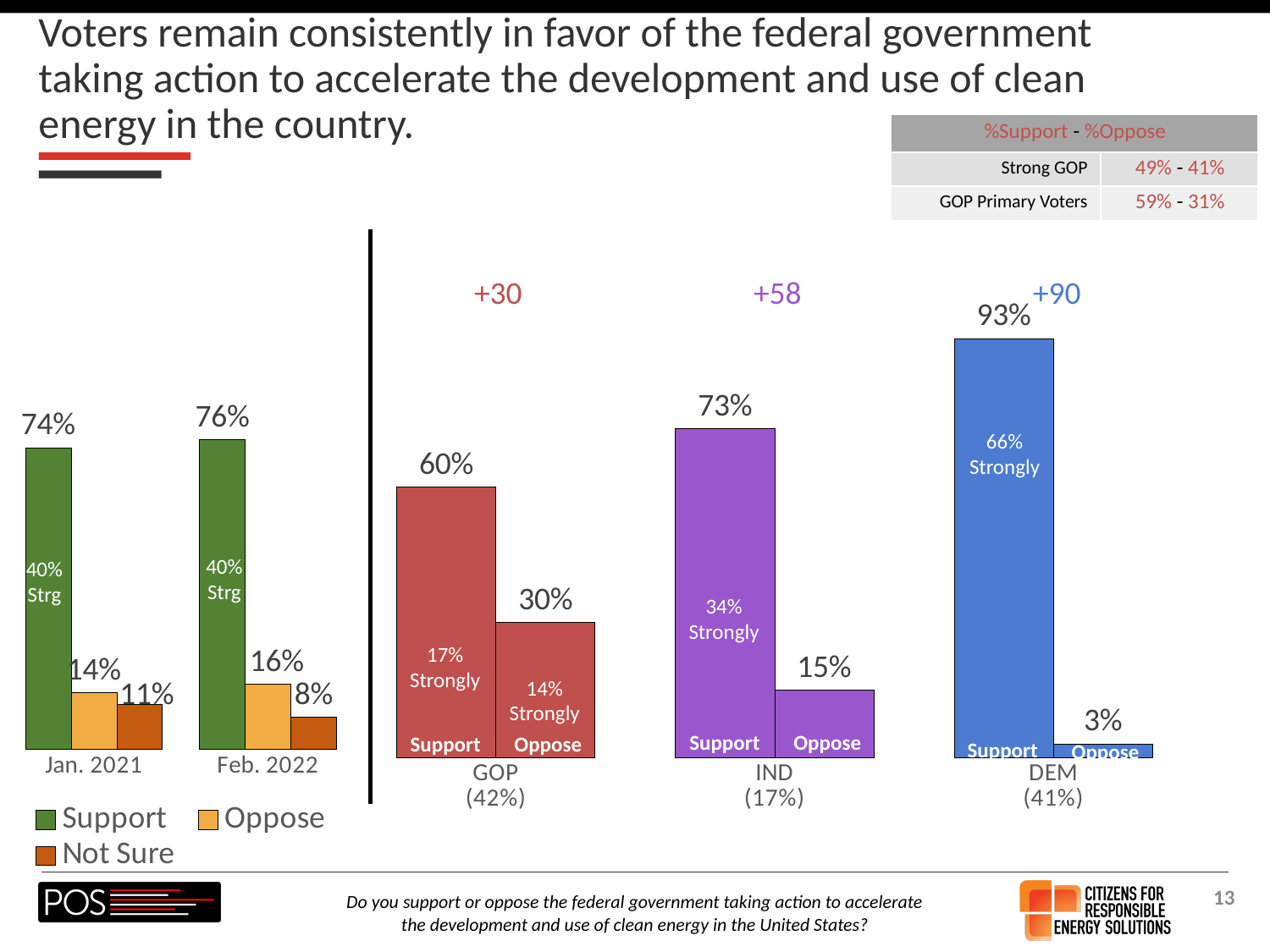
In the left chart, does Support rise or fall from Jan. 2021 to Feb. 2022? rise In the right chart (by party), what is the difference between GOP Support and GOP Oppose? 30 percentage points In the right chart (by party), which group has the highest Support value? DEM In the right chart (by party), what is the Support value for IND? 73% In the left chart, by how many percentage points did Support change from Jan. 2021 to Feb. 2022? 2 percentage points In the left chart, what is the Support value for Feb. 2022? 76% How many series does the legend of the left chart list? 3 In the right chart (by party), which is larger: the Oppose value for GOP or the Oppose value for IND? GOP What kind of chart is the right chart (by party)? bar chart In the right chart (by party), what percentage of DEM voters strongly support? 66% In the right chart (by party), which group has the lowest Oppose value? DEM In the left chart, what is the Not Sure value for Jan. 2021? 11%